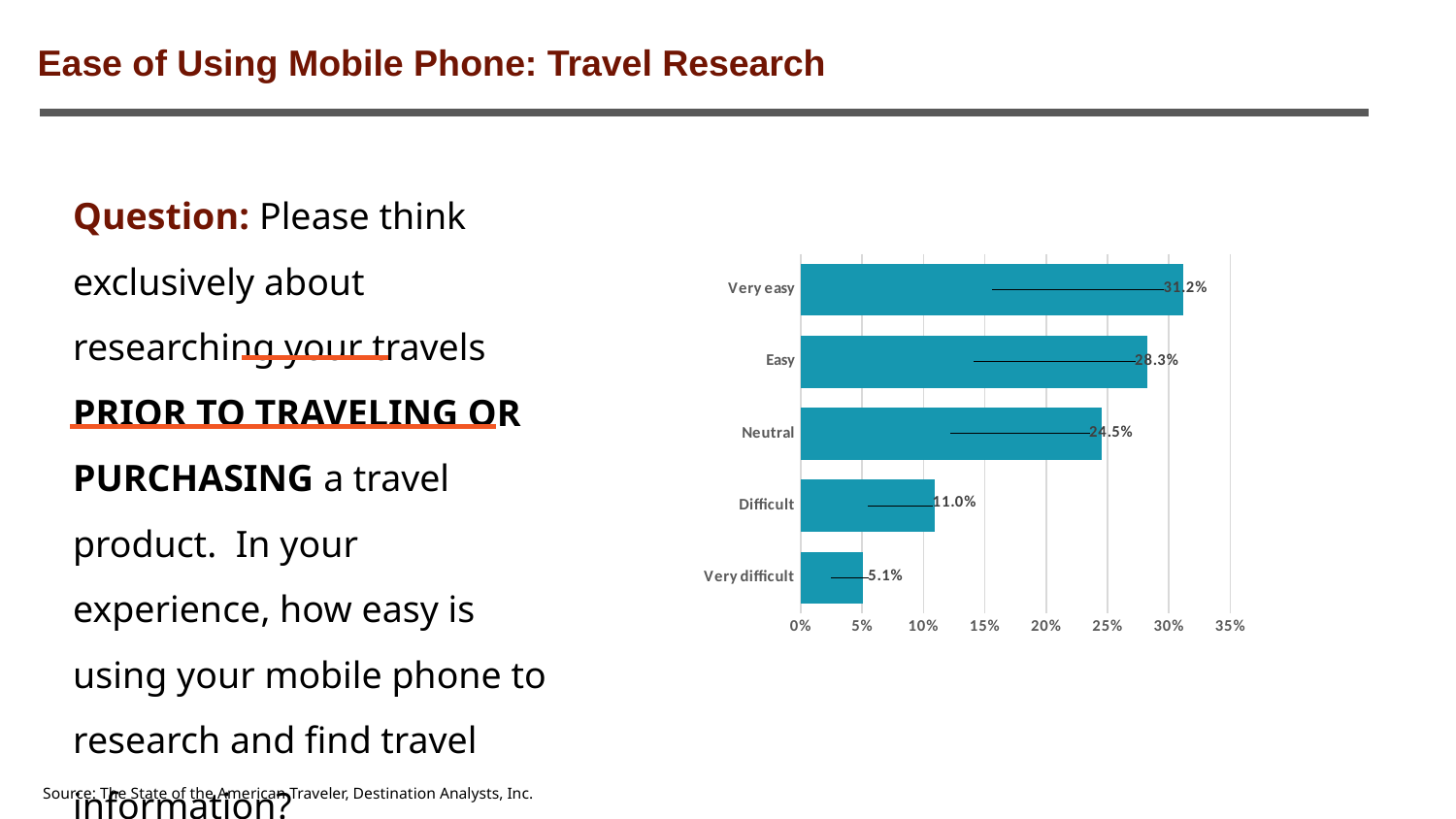
Which category has the lowest value? Very difficult Is the value for Difficult greater or less than 15%? less Which category has the highest value? Very easy What is the title of the slide containing the chart? Ease of Using Mobile Phone: Travel Research How many categories are shown in the chart? 5 What is the value for Very easy? 31.2% What is the value for Very difficult? 5.1% What is the difference between the values for Very easy and Easy? 2.9% What is the value for Neutral? 24.5% What kind of chart is shown on the slide? bar chart Which is larger, the value for Easy or the value for Neutral? Easy What is the difference between the values for Difficult and Very difficult? 5.9%